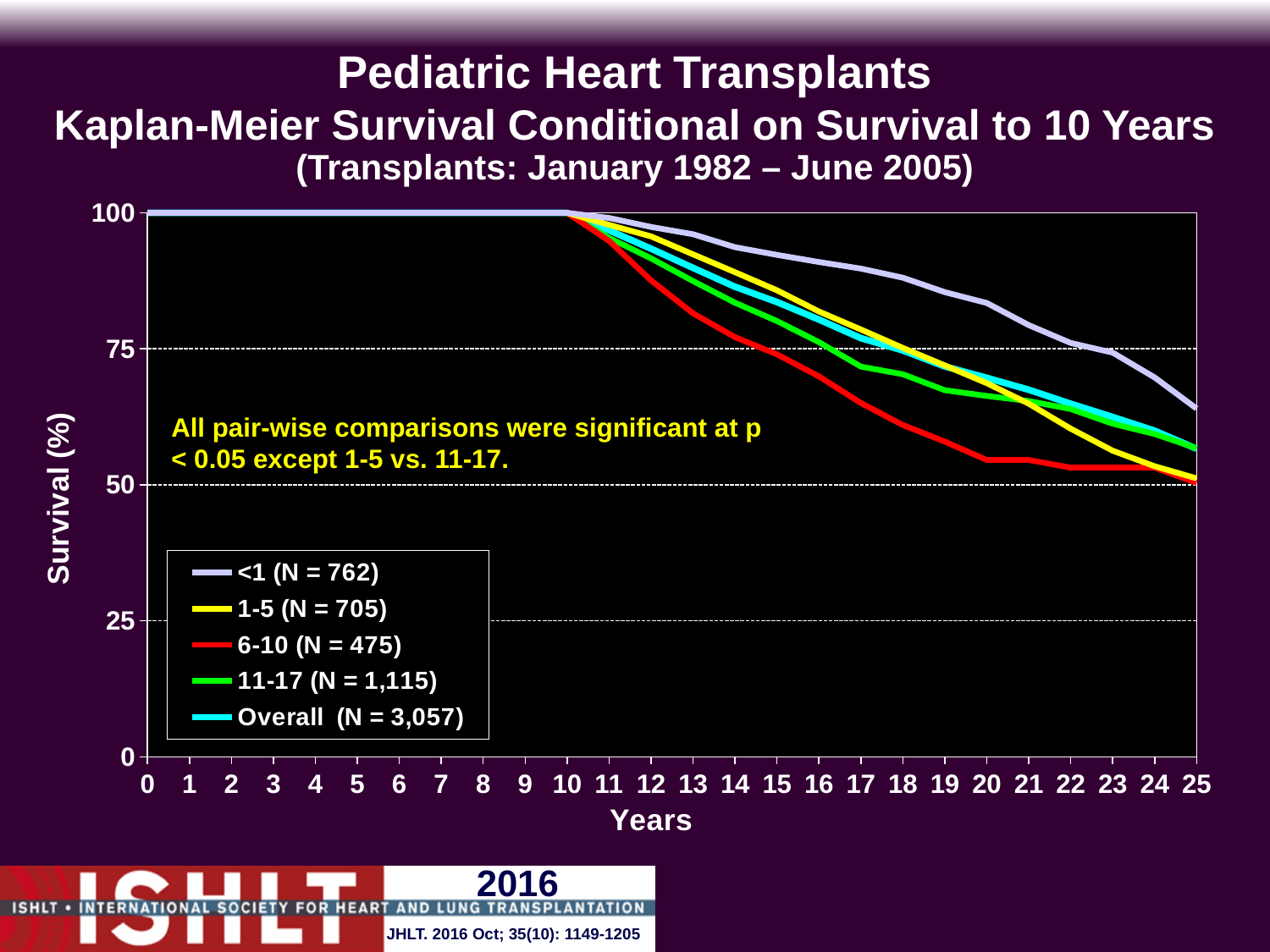
What kind of chart is shown on the slide? line chart What is the N for the Overall series shown in the legend? 3,057 Which age group has the lowest survival at year 20? 6-10 At year 17, which has the higher survival: the <1 group or the 6-10 group? <1 After year 10, do the survival curves rise or fall as years increase? fall Is the survival value for the 6-10 group at year 20 greater or less than 75? less Is the survival value for the <1 group at year 20 greater or less than 75? greater Is the survival value for the 1-5 group at year 15 greater or less than 75? greater What is the survival value for the Overall series at year 5? 100 What is the N for the <1 age group shown in the legend? 762 Which age group has the highest survival at year 25? <1 How many series does the legend list? 5